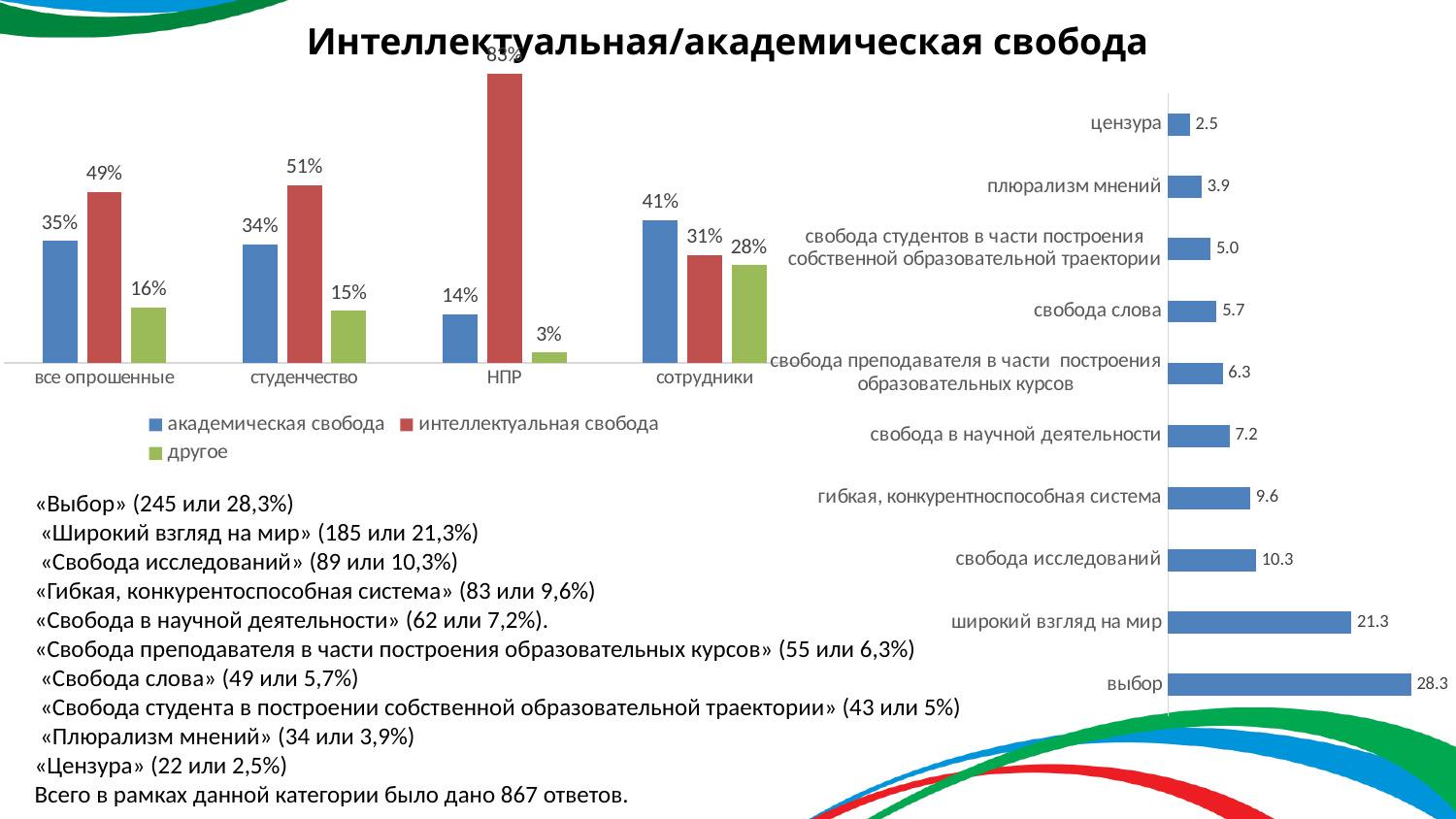
In the right chart, which category has the highest value? выбор In the right chart, what is the difference between 'выбор' and 'широкий взгляд на мир'? 7.0 In the left chart, what is the difference between 'интеллектуальная свобода' and 'академическая свобода' for 'студенчество'? 17% What kind of chart is the right chart? bar chart In the left chart, what is the value for 'академическая свобода' in the 'сотрудники' group? 41% In the right chart, what is the value for 'широкий взгляд на мир'? 21.3 In the left chart, what is the value for 'интеллектуальная свобода' in the 'все опрошенные' group? 49% In the right chart, which category has the lowest value? цензура In the left chart, which is larger for 'сотрудники': 'академическая свобода' or 'интеллектуальная свобода'? академическая свобода How many category groups are shown on the x axis of the left chart? 4 In the left chart, what is the value for 'другое' in the 'НПР' group? 3% How many series does the legend of the left chart list? 3